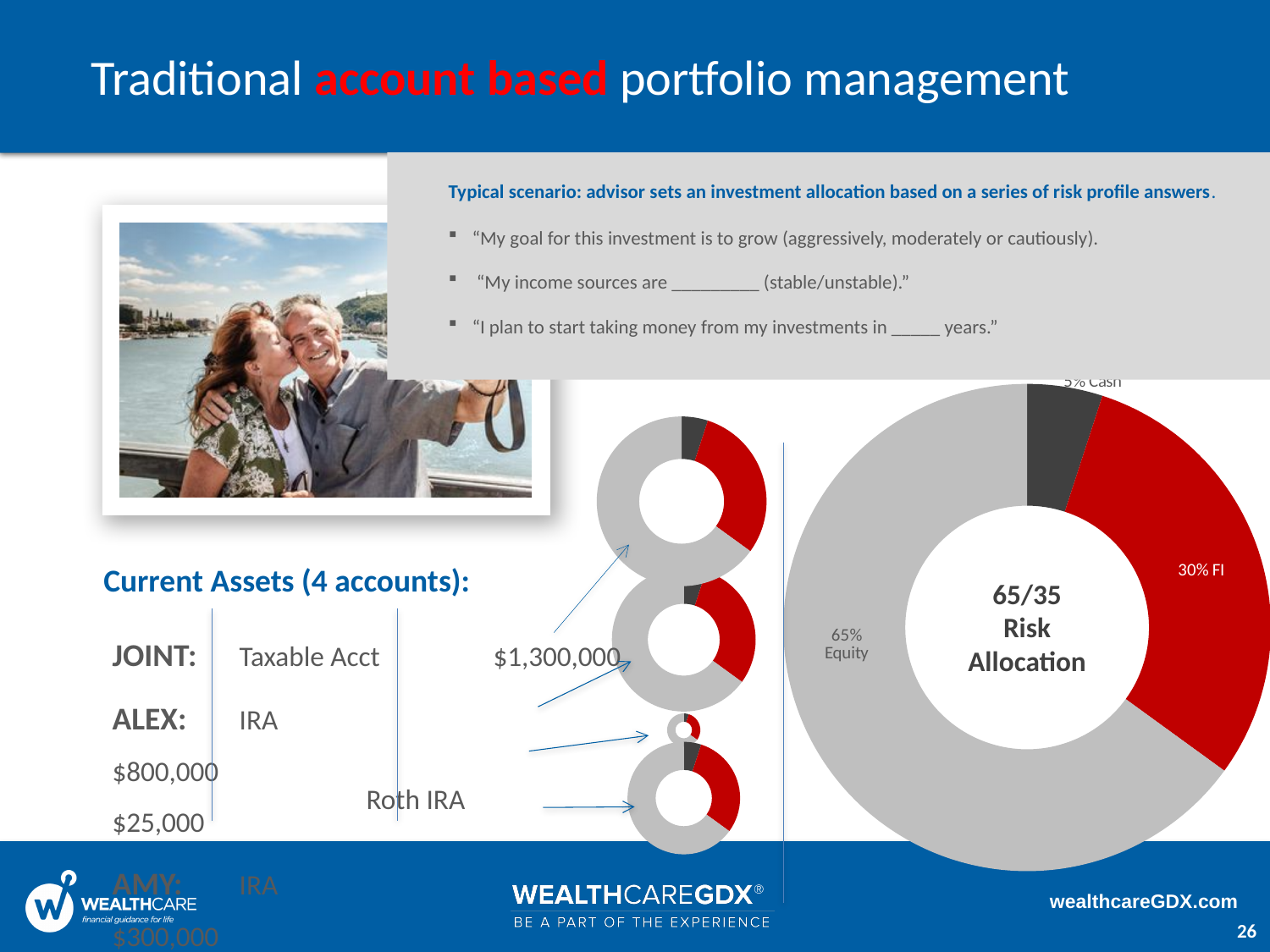
How many slices does the large donut chart on the right have? 3 In the large donut chart on the right, what colour is the FI slice? red In the large donut chart on the right, which is larger, the FI share or the Cash share? FI In the large donut chart on the right, how many percentage points larger is the Equity share than the FI share? 35 percentage points In the large donut chart on the right, what share is allocated to Equity? 65% What kind of chart is the large chart on the right side of the slide? donut chart What text is printed in the centre of the large donut chart on the right? 65/35 Risk Allocation In the large donut chart on the right, what share is allocated to FI? 30% In the large donut chart on the right, what is the combined share of Equity and FI? 95% In the large donut chart on the right, which category has the smallest share? Cash In the large donut chart on the right, what share is allocated to Cash? 5% In the large donut chart on the right, which category has the largest share? Equity